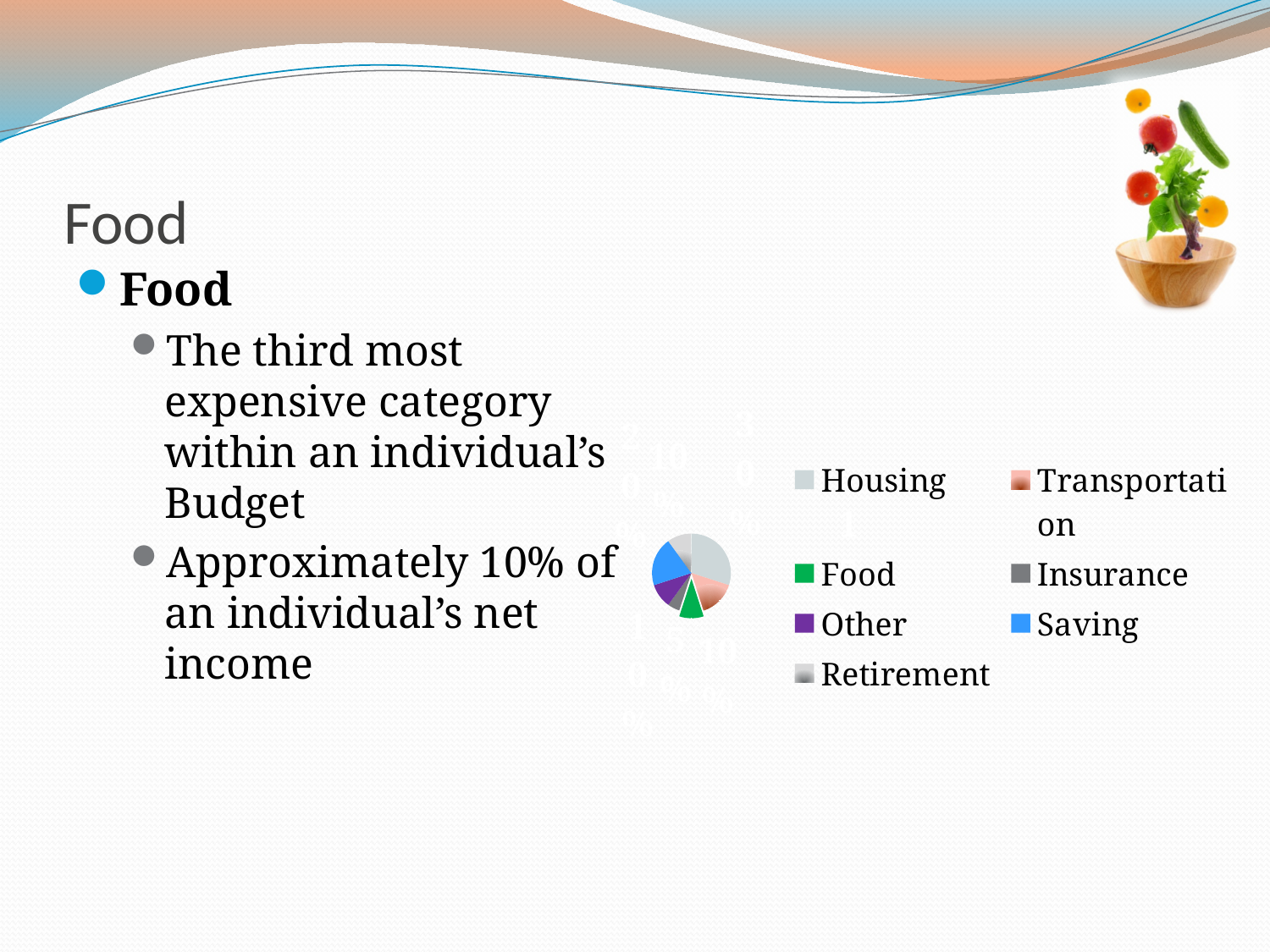
Which category is shown in blue in the pie chart's legend? Saving Which category has the largest slice in the pie chart? Housing Which slice is larger in the pie chart, Housing or Food? Housing What colour represents Food in the pie chart? green What kind of chart is shown on the slide? pie chart How many categories does the pie chart's legend list? 7